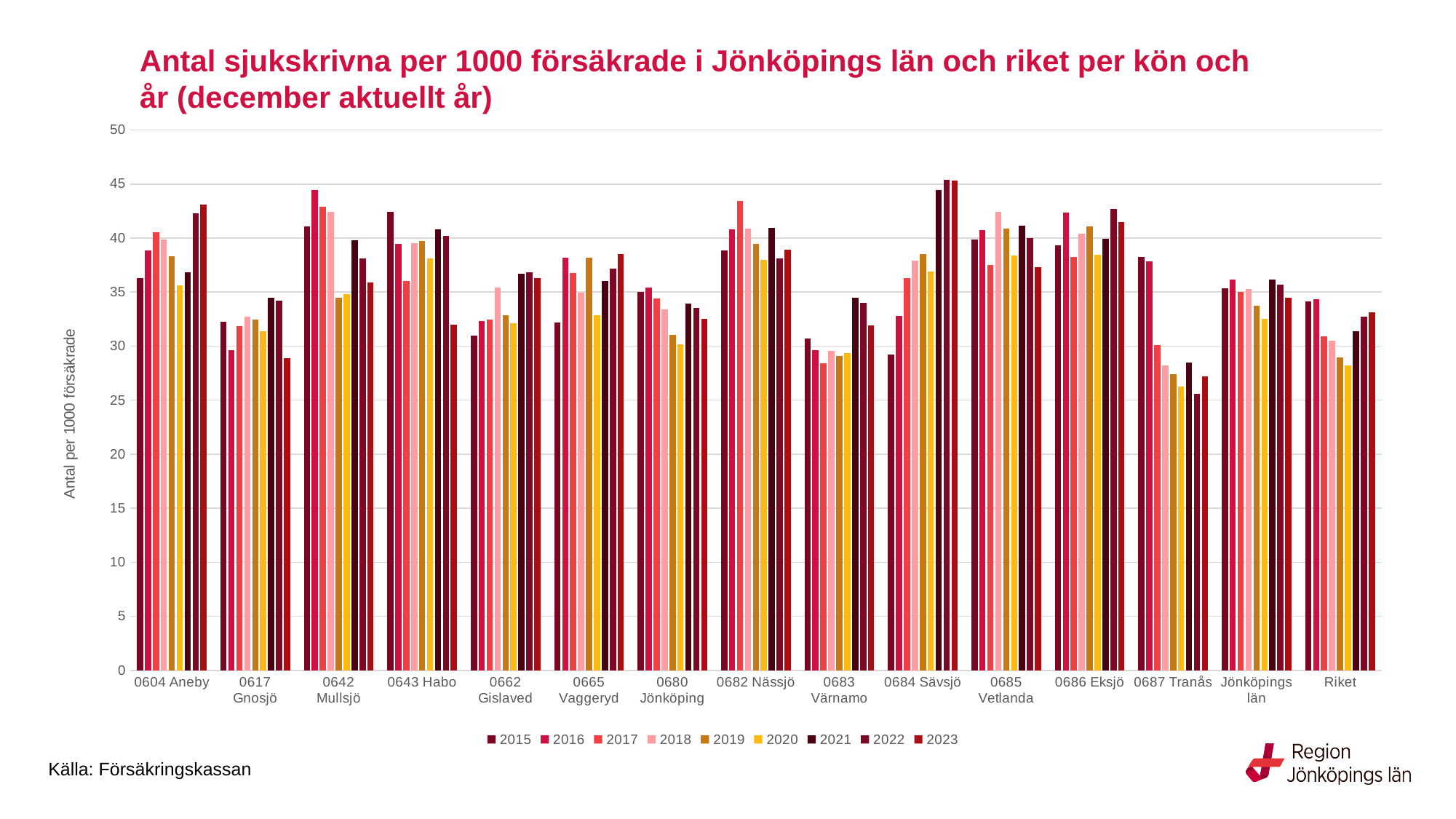
Which is larger, the 2023 value for 0604 Aneby or the 2023 value for 0687 Tranås? 0604 Aneby Within 0643 Habo, which year has the highest value? 2015 Is the value for 2016 in 0642 Mullsjö greater or less than 40? greater How many categories are shown along the x axis? 15 Within 0684 Sävsjö, which is larger, the 2015 value or the 2022 value? 2022 Is the value for 2015 in 0684 Sävsjö greater or less than 30? less Is the value for 2023 in 0687 Tranås greater or less than 30? less How many series does the legend list? 9 What is the source given at the bottom of the slide? Försäkringskassan What kind of chart is shown on the slide? bar chart Do the values for 0687 Tranås generally rise or fall from 2015 to 2023? fall